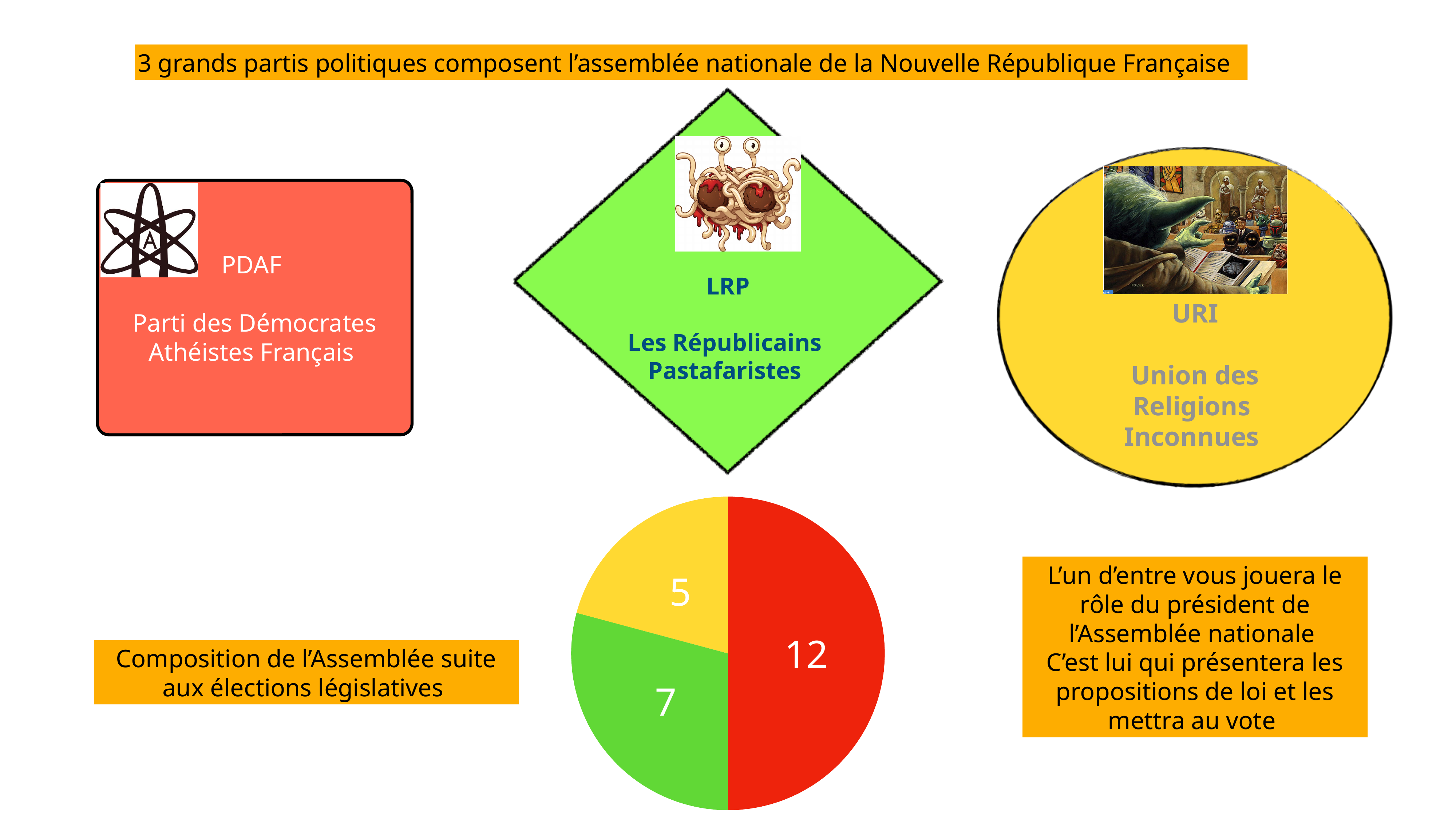
Which is larger in the pie chart, the green slice or the yellow slice? the green slice What is the difference between the red slice and the green slice of the pie chart? 5 What is the difference between the green slice and the yellow slice of the pie chart? 2 How many slices does the pie chart have? 3 What value is shown on the yellow slice of the pie chart? 5 What value is shown on the red slice of the pie chart? 12 Which slice of the pie chart has the smallest value? the yellow slice (5) What value is shown on the green slice of the pie chart? 7 What is the total of all the values shown in the pie chart? 24 Which slice of the pie chart has the largest value? the red slice (12) What share of the pie chart does the red slice represent? 50% What kind of chart is shown at the bottom of the slide? pie chart